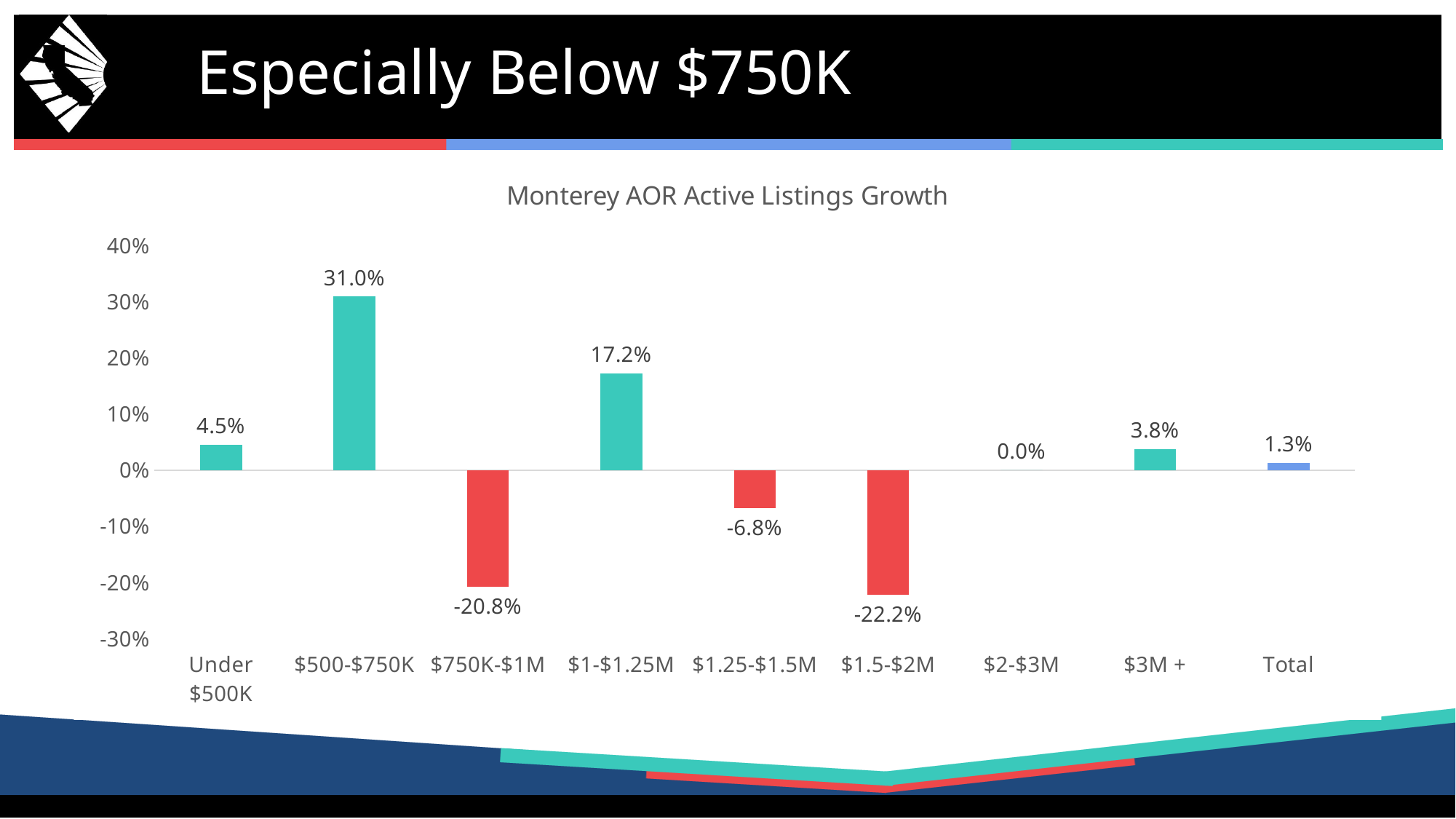
What is the active listings growth for the $1.5-$2M price range? -22.2% What is the value shown for Total? 1.3% What is the active listings growth for the $2-$3M price range? 0.0% Which price range has the lowest active listings growth? $1.5-$2M What is the active listings growth for the $500-$750K price range? 31.0% What colour are the bars with negative values? Red Which is larger, the growth for Under $500K or for $3M +? Under $500K Which price range has the highest active listings growth? $500-$750K What is the difference between the growth for $500-$750K and $1-$1.25M? 13.8% How many categories are shown on the x axis? 9 What is the title of the chart? Monterey AOR Active Listings Growth What kind of chart is shown on the slide? Bar chart